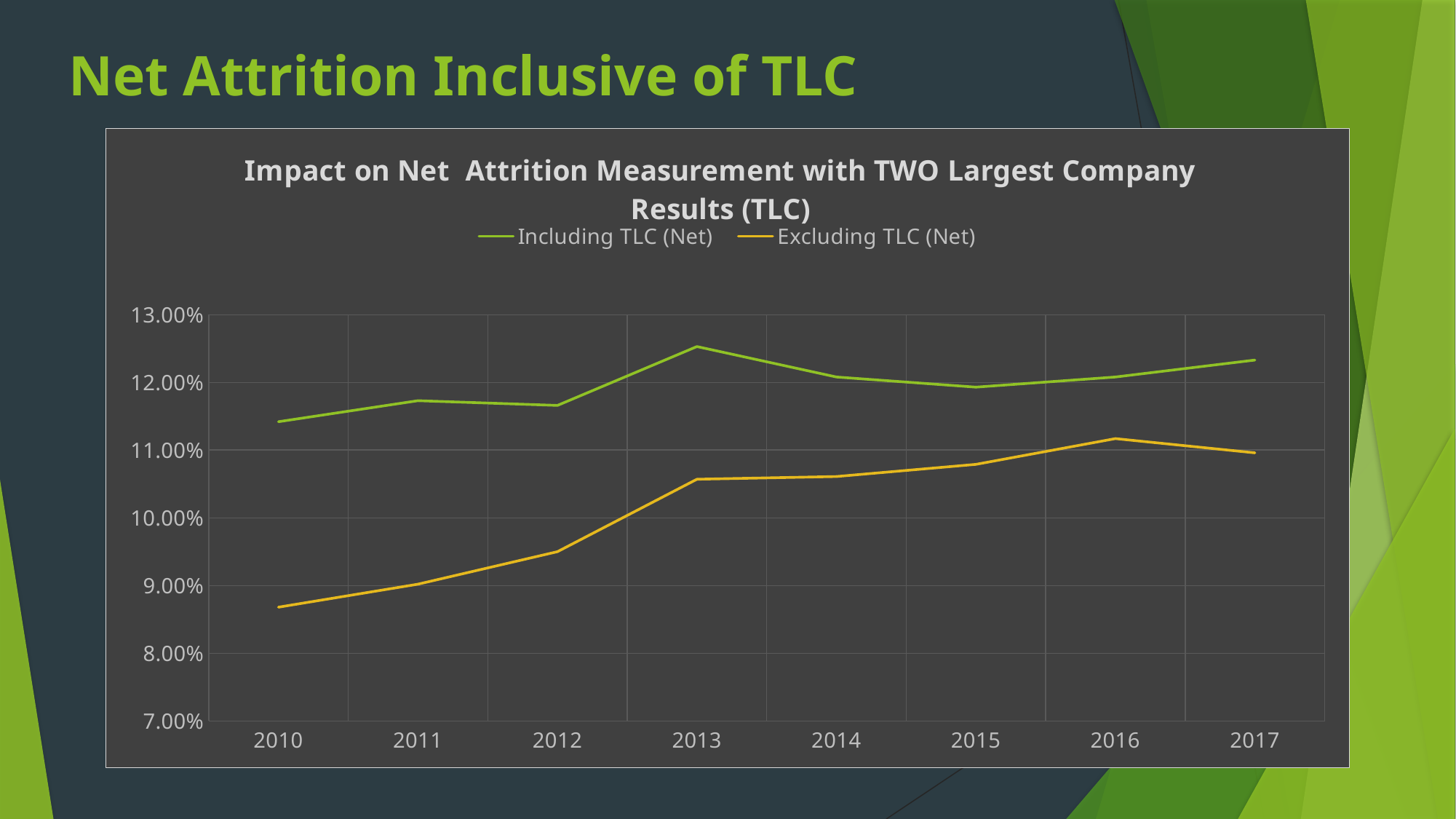
What kind of chart is shown on the slide? line chart Which series has the larger value in 2013, Including TLC (Net) or Excluding TLC (Net)? Including TLC (Net) In which year does the Excluding TLC (Net) series reach its highest value? 2016 Is the value for Excluding TLC (Net) in 2016 greater or less than 11.00%? greater Does the Excluding TLC (Net) series generally rise or fall from 2010 to 2016? rise In which year does the Including TLC (Net) series reach its highest value? 2013 Is the value for Including TLC (Net) in 2013 greater or less than 12.00%? greater In which year is the Excluding TLC (Net) series at its lowest? 2010 How many series does the legend list? 2 How many years are plotted along the x axis? 8 Is the value for Excluding TLC (Net) in 2010 greater or less than 9.00%? less What colour is the line for the Excluding TLC (Net) series? orange